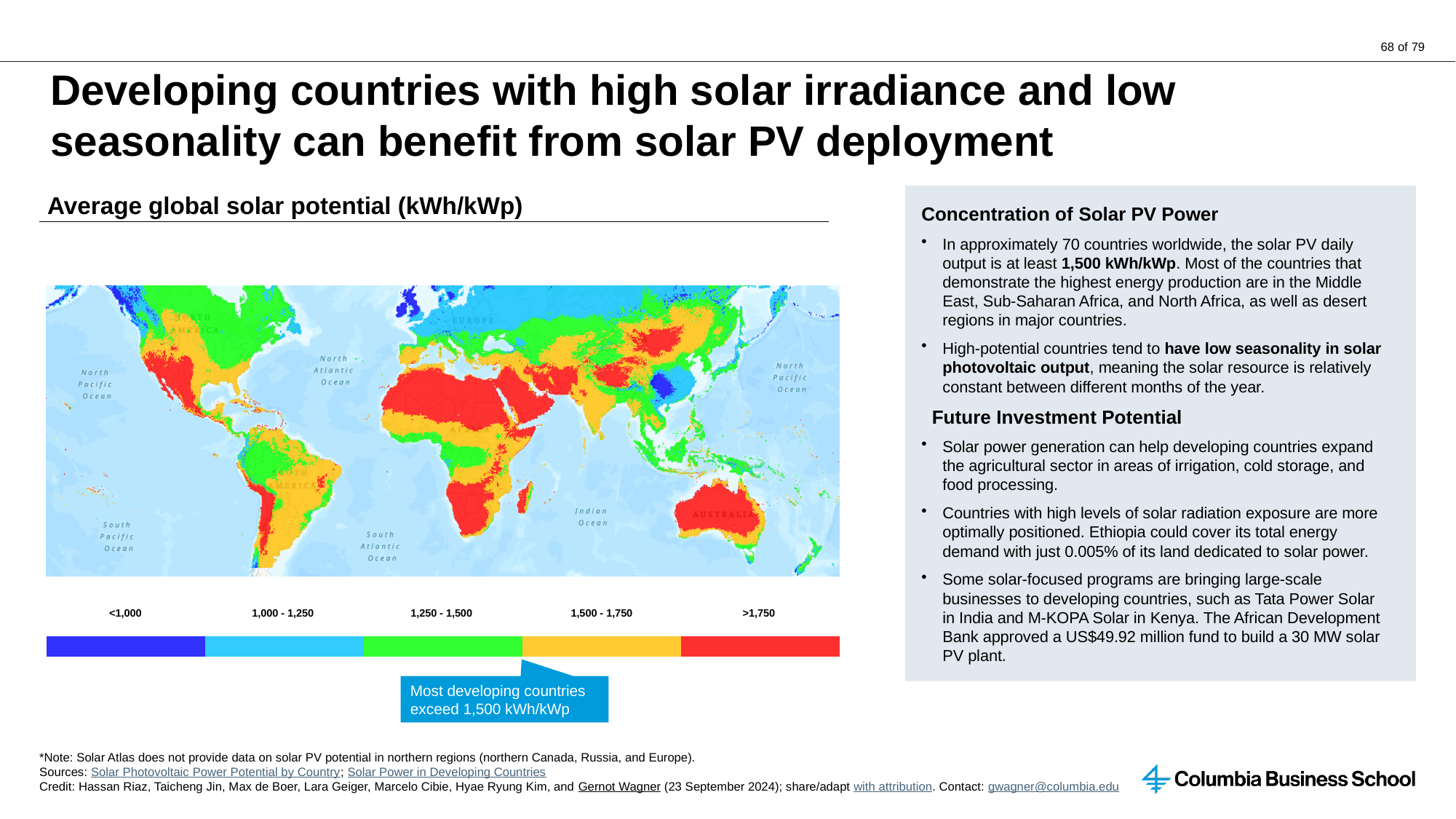
Is the solar potential shown for most of Australia greater or less than 1,750 kWh/kWp? greater What is the lowest value range shown in the map legend? <1,000 Is the solar potential shown for the Amazon basin in South America greater or less than 1,500 kWh/kWp? less Which region has higher solar potential on the map: the Sahara or the Amazon basin? Sahara Which colour on the map represents solar potential greater than 1,750 kWh/kWp? Red What kind of chart is used to show average global solar potential? Map (heat map) Is the solar potential shown for the Sahara region of North Africa greater or less than 1,750 kWh/kWp? greater What is the title of the map chart on the slide? Average global solar potential (kWh/kWp) How many value ranges does the legend below the map list? 5 What is the highest value range shown in the map legend? >1,750 According to the callout below the legend, what value do most developing countries exceed? 1,500 kWh/kWp